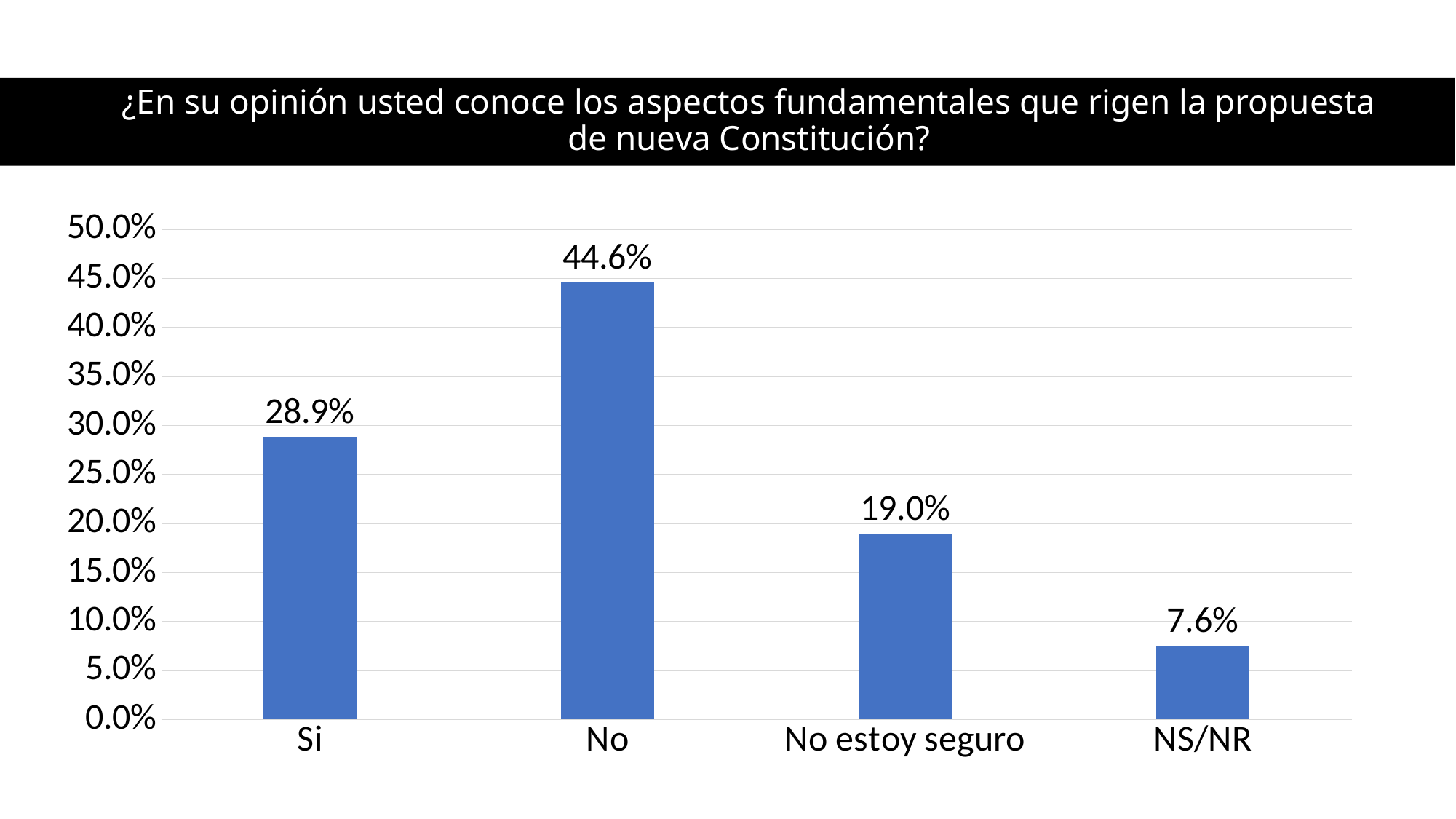
Which category has the highest value? No What is the value for "No"? 44.6% What is the value for "Si"? 28.9% How many categories are shown on the x axis? 4 What is the difference between the values for "No" and "Si"? 15.7% What is the value for "No estoy seguro"? 19.0% Which category has the lowest value? NS/NR Which is larger, the value for "Si" or the value for "No estoy seguro"? Si What is the value for "NS/NR"? 7.6% What is the difference between the values for "No estoy seguro" and "NS/NR"? 11.4% What is the maximum value shown on the y axis? 50.0% What kind of chart is shown on the slide? Bar chart